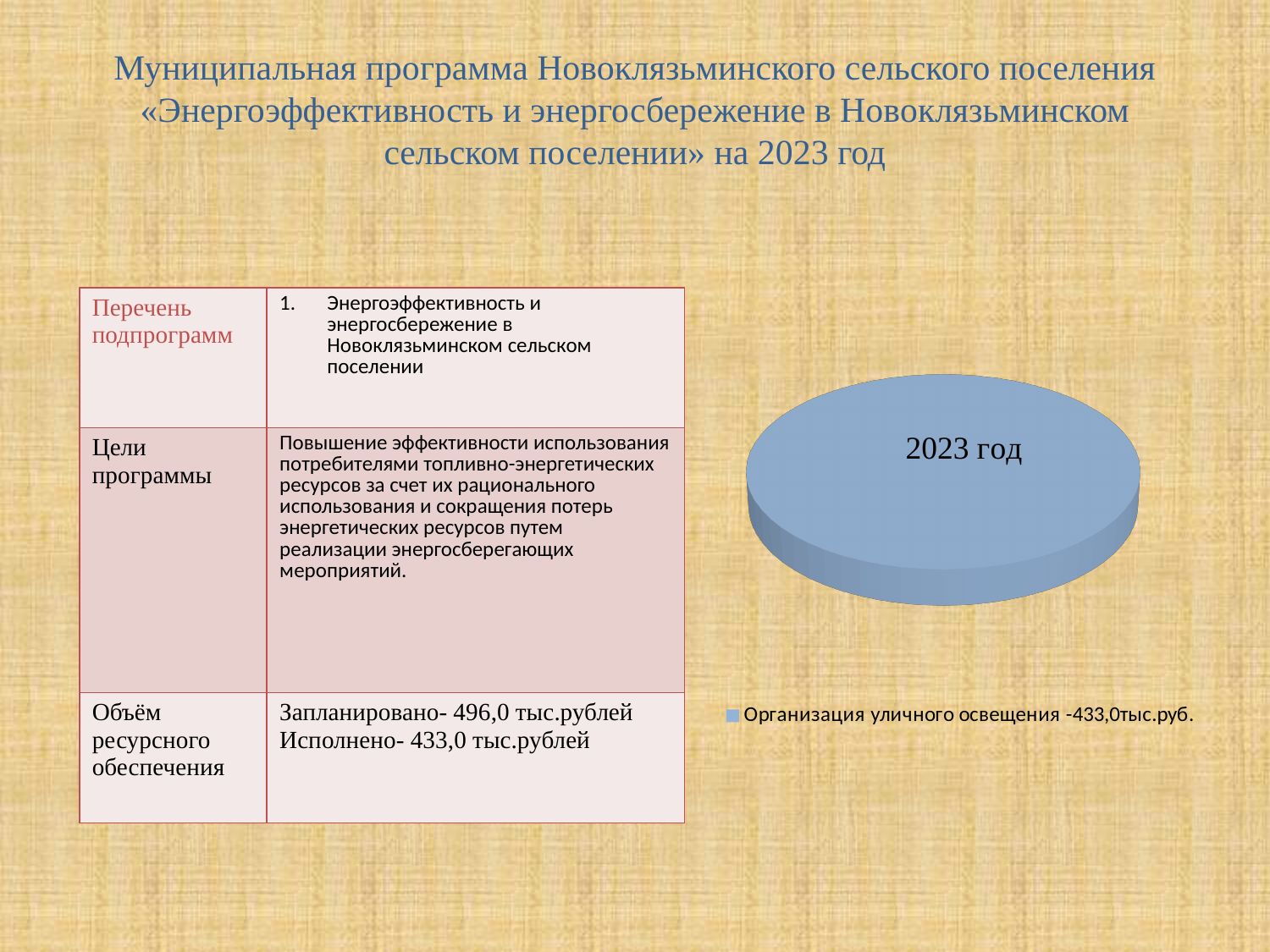
What share of the pie chart does "Организация уличного освещения" take up? 100% What value is given in the legend for "Организация уличного освещения"? 433,0тыс.руб. What is the title of the pie chart? 2023 год What colour is the single slice of the pie chart? blue How many entries does the legend of the pie chart list? 1 How many slices does the pie chart contain? 1 What kind of chart is shown on the right side of the slide? pie chart